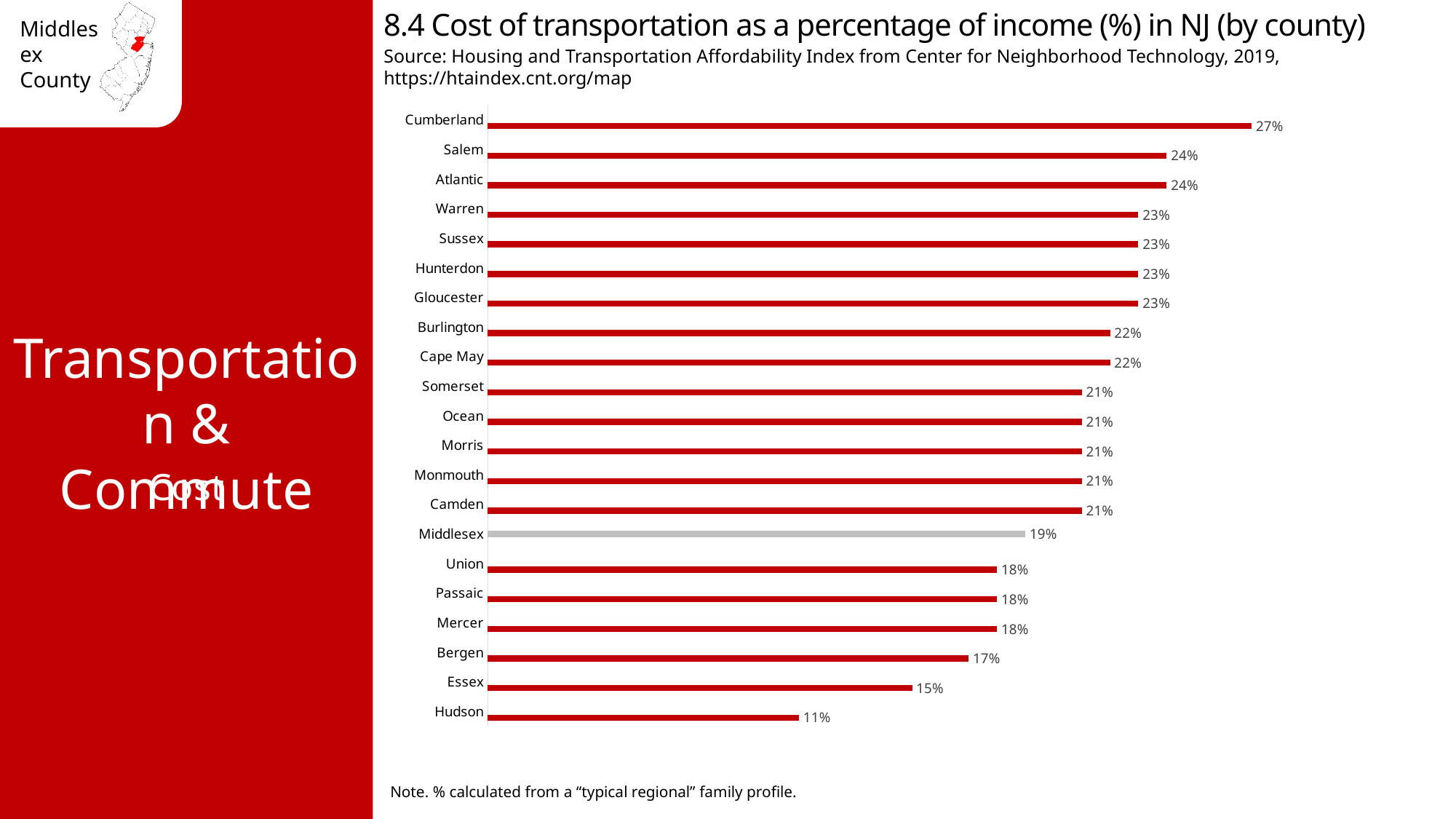
Which county has a larger value, Bergen or Essex? Bergen What is the cost of transportation as a percentage of income for Cumberland County? 27% What is the difference between the values for Cumberland and Hudson? 16% What kind of chart is shown on the slide? Bar chart What is the value shown for Hudson County? 11% Which county's bar is shown in grey rather than red? Middlesex What is the cost of transportation as a percentage of income for Middlesex County? 19% What is the difference between the values for Middlesex and Essex? 4% Which county has the highest cost of transportation as a percentage of income? Cumberland Which county has the lowest cost of transportation as a percentage of income? Hudson Which county has a larger value, Salem or Burlington? Salem How many counties are shown in the chart? 21